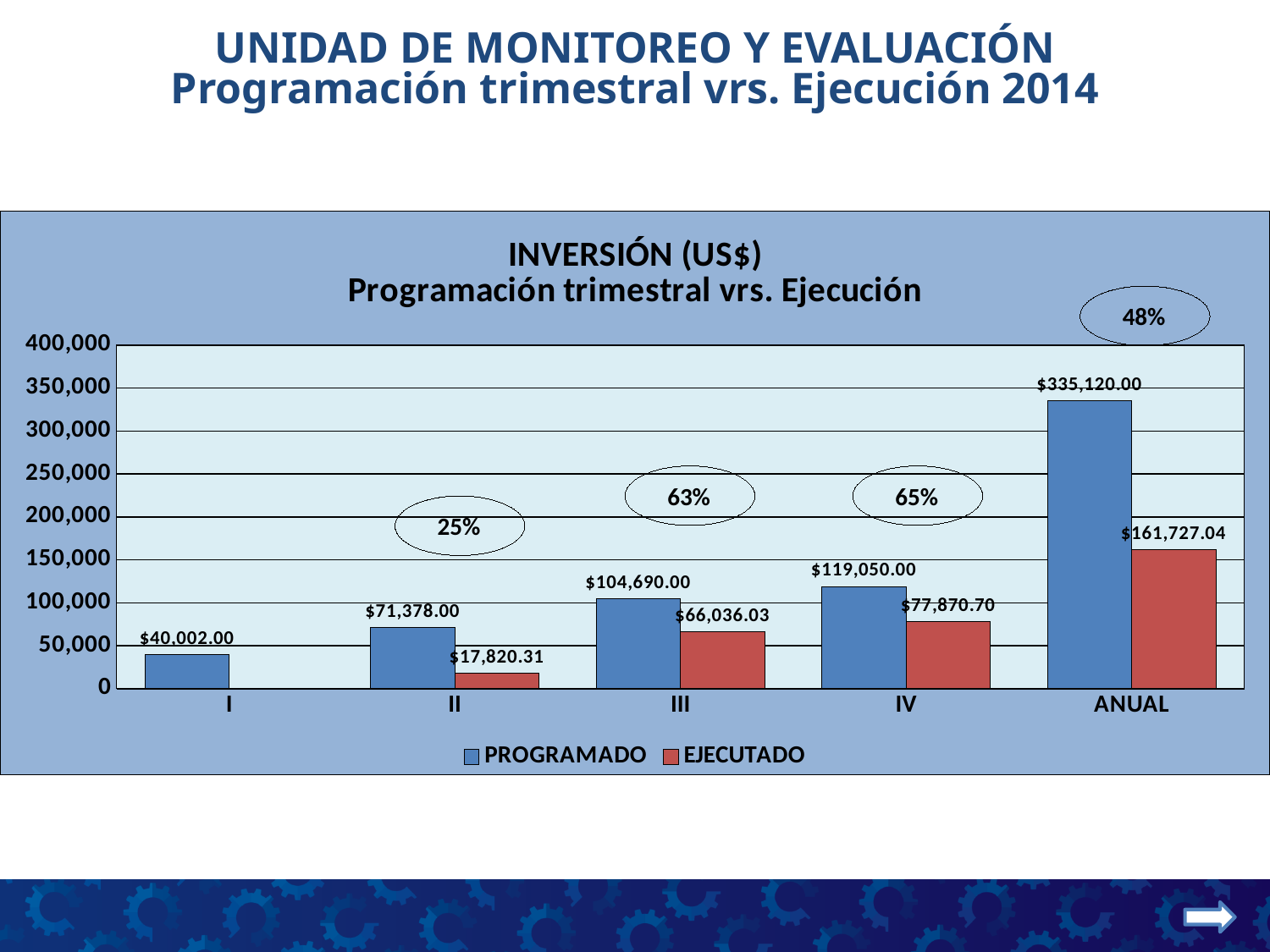
Which is larger for quarter III, the PROGRAMADO value or the EJECUTADO value? PROGRAMADO What is the difference between the PROGRAMADO and EJECUTADO values for quarter IV? $41,179.30 What percentage is shown in the circle above the ANUAL bars? 48% What is the PROGRAMADO value for quarter III? $104,690.00 How many series does the legend list? 2 What is the EJECUTADO value for quarter II? $17,820.31 How many categories are shown on the x axis? 5 What is the EJECUTADO value for ANUAL? $161,727.04 Which quarter has the lowest PROGRAMADO value? I Which category has the highest PROGRAMADO value? ANUAL Do the PROGRAMADO values rise or fall from quarter I to quarter IV? rise What type of chart is shown on the slide? bar chart